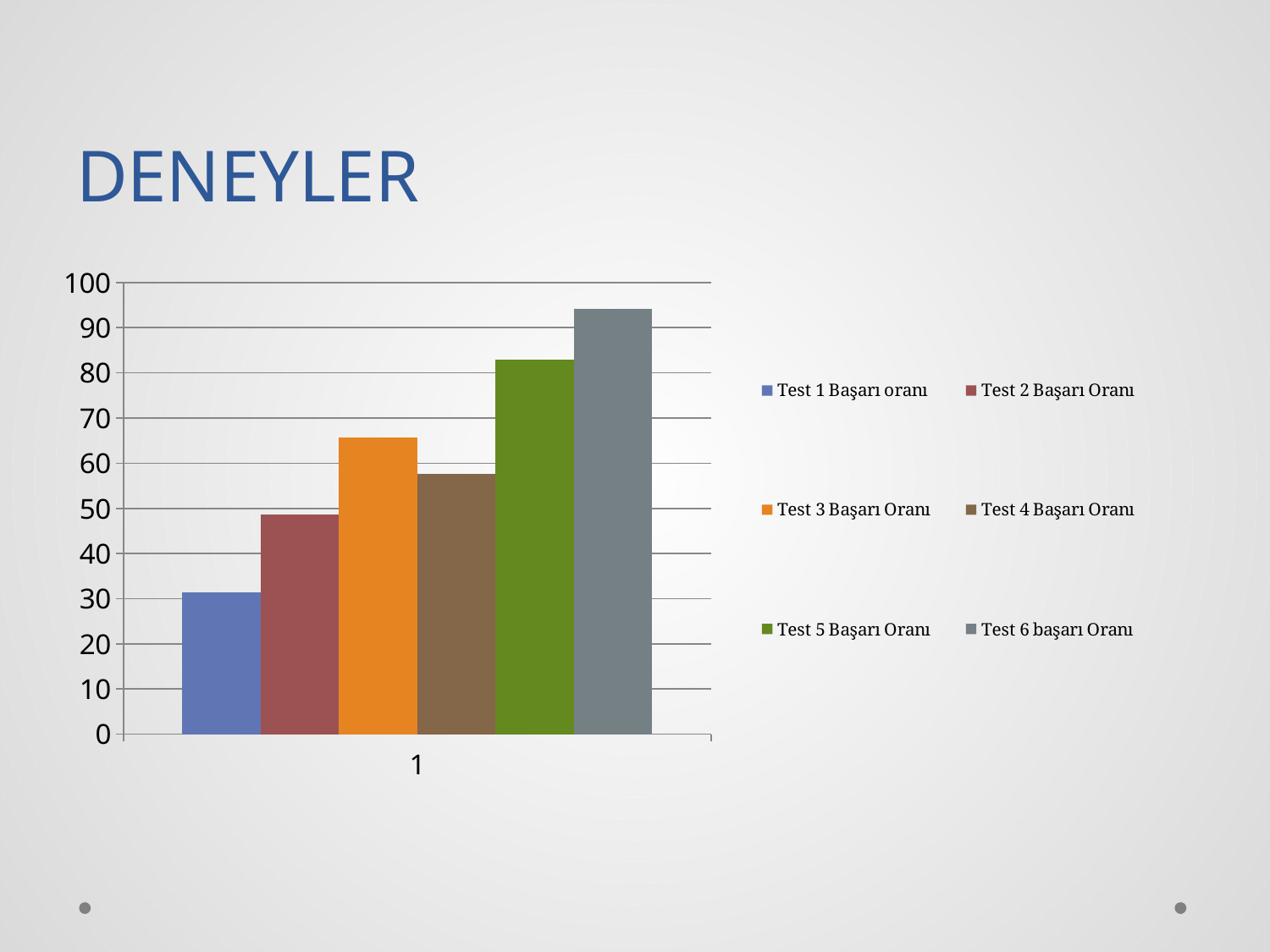
Is the value for Test 4 Başarı Oranı greater or less than 50? greater Which series has the highest bar? Test 6 başarı Oranı Is the value for Test 5 Başarı Oranı greater or less than 90? less Is the value for Test 6 başarı Oranı greater or less than 90? greater What is the title of the slide containing the chart? DENEYLER How many categories are shown on the x axis? 1 What kind of chart is shown on the slide? bar chart Which series has the lowest bar? Test 1 Başarı oranı Which is larger, the value for Test 3 Başarı Oranı or Test 4 Başarı Oranı? Test 3 Başarı Oranı How many series does the legend list? 6